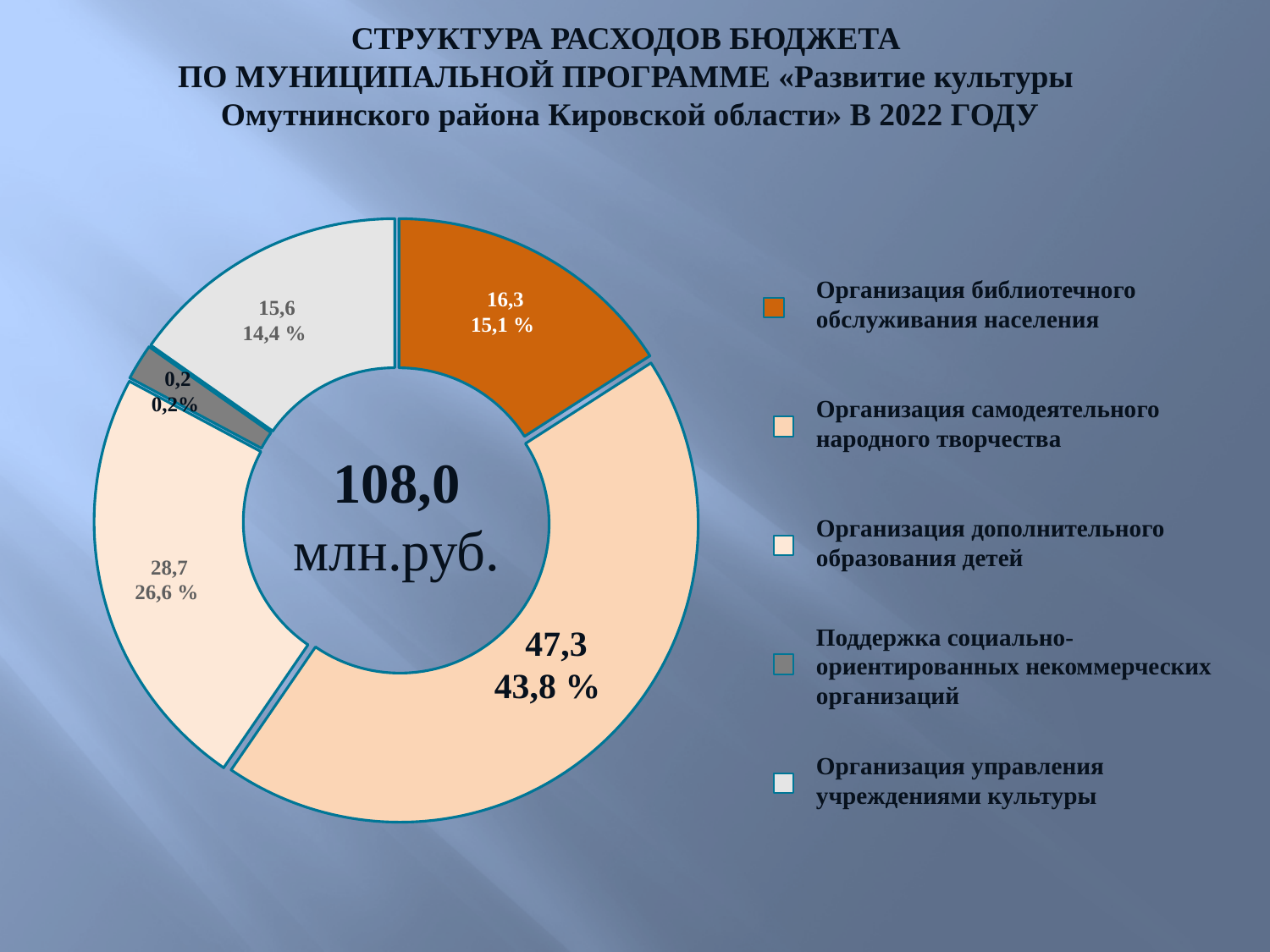
Which category has the smallest slice of the pie? Поддержка социально-ориентированных некоммерческих организаций (0,2) What kind of chart is shown on the slide? pie chart (doughnut) How many entries does the legend list? 5 How many slices does the pie chart have? 5 What percentage share does the orange slice «Организация библиотечного обслуживания населения» have? 15,1 % What is the value (in млн.руб.) for «Организация библиотечного обслуживания населения»? 16,3 What is the difference between the 47,3 slice and the 28,7 slice? 18,6 What total amount is printed in the centre of the doughnut chart? 108,0 млн.руб. What percentage share is shown for the grey slice «Поддержка социально-ориентированных некоммерческих организаций»? 0,2% Which is larger: the slice labelled 16,3 or the slice labelled 15,6? 16,3 Which category has the largest slice of the pie? Организация самодеятельного народного творчества (47,3) What is the percentage share of the largest slice? 43,8 %